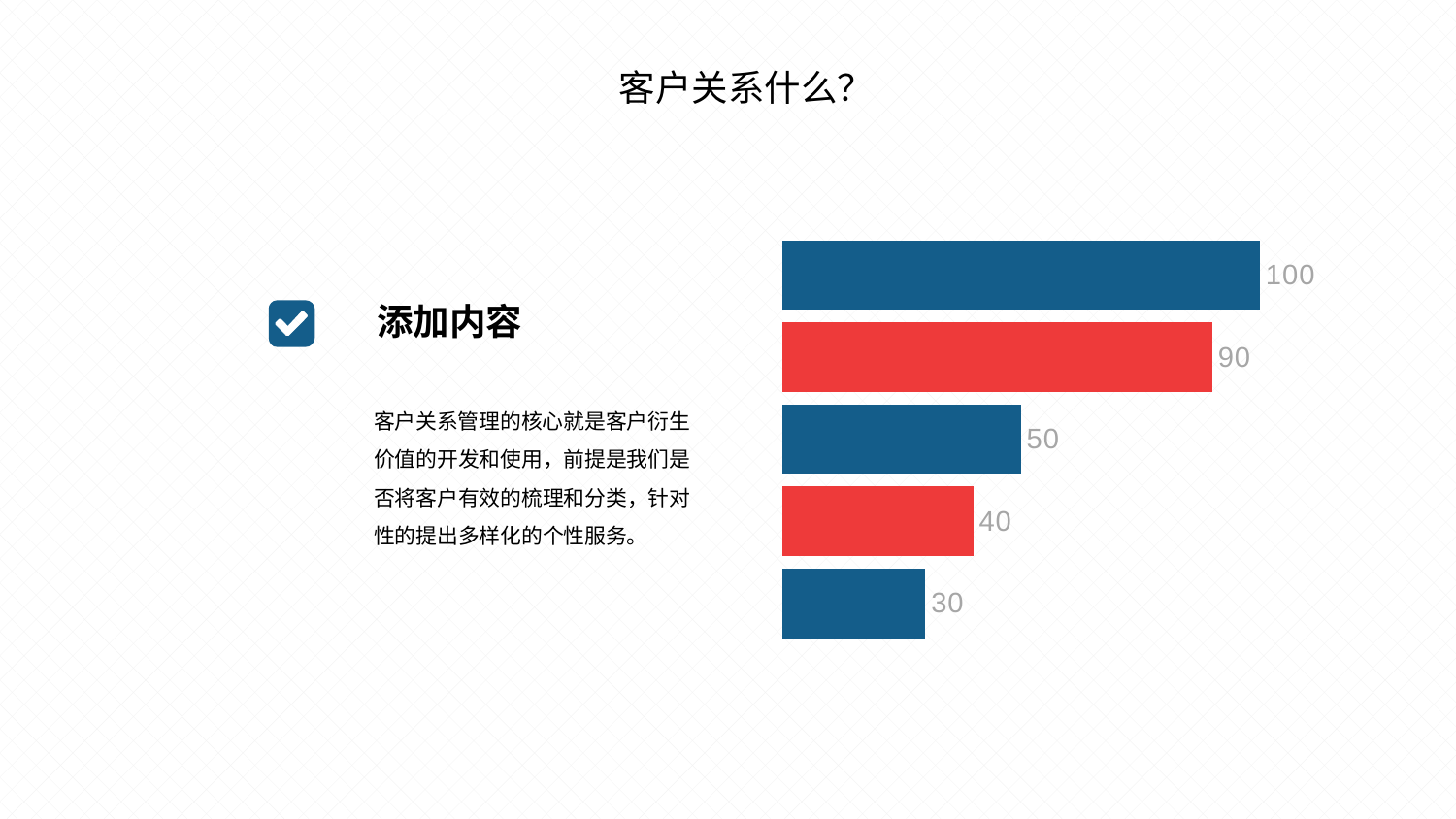
What is the lowest value shown in the chart? 30 What is the highest value shown in the chart? 100 What is the value of the top bar in the chart? 100 What is the value of the middle (third) bar? 50 What is the value of the second bar from the top? 90 What kind of chart is shown on the slide? bar chart Which is larger, the fourth bar from the top or the bottom bar? the fourth bar (40) Do the bar values increase or decrease from the top of the chart to the bottom? decrease How many bars does the chart contain? 5 What is the difference between the third bar (50) and the bottom bar (30)? 20 What is the difference between the top bar and the second bar? 10 What is the value of the bottom bar in the chart? 30